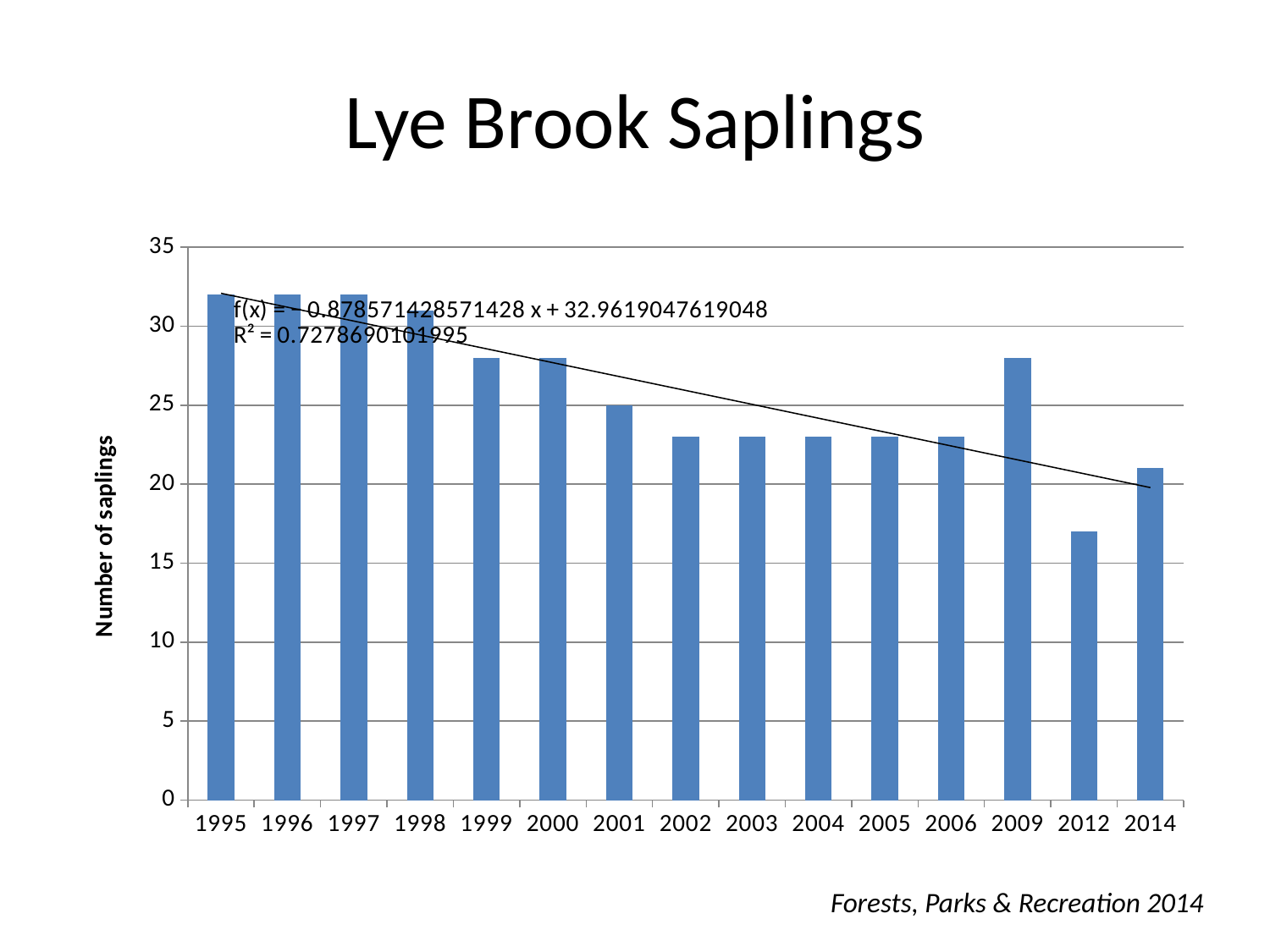
What is the label on the vertical axis of the chart? Number of saplings Is the value for 2003 greater or less than 25? less Which year has more saplings, 2001 or 2014? 2001 Is the value for 1995 greater or less than 30? greater What is the title of the chart? Lye Brook Saplings Is the value for 2009 greater or less than 25? greater Which year has more saplings, 2009 or 2012? 2009 How many years are shown on the x axis of the chart? 15 Which year has the lowest number of saplings? 2012 Overall, do the number of saplings rise or fall from 1995 to 2014? fall What kind of chart is shown on the slide? bar chart